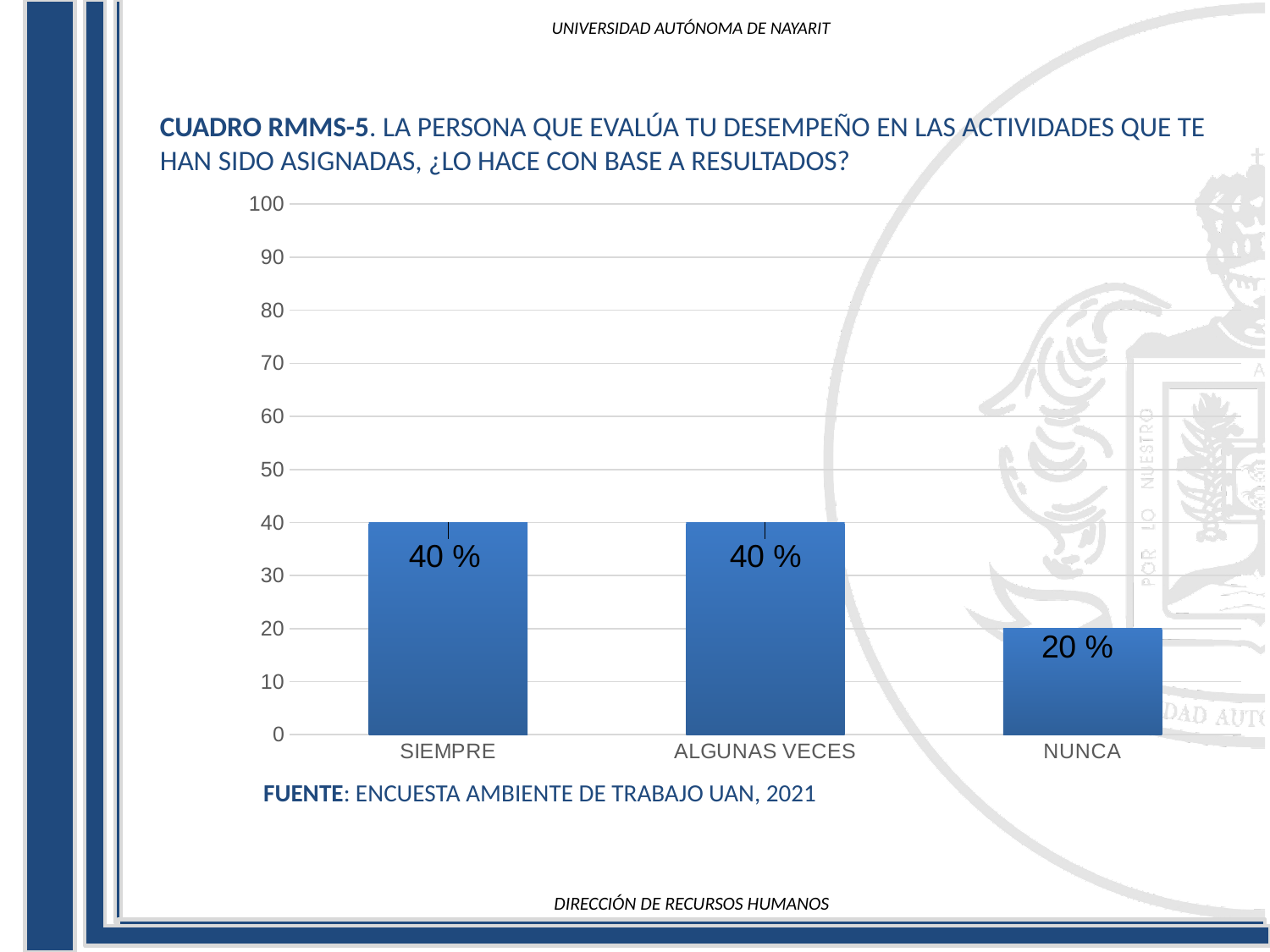
Which is larger, the value for ALGUNAS VECES or the value for NUNCA? ALGUNAS VECES What is the value for ALGUNAS VECES? 40 % Is the value for SIEMPRE greater or less than 50? less What source is cited below the chart? ENCUESTA AMBIENTE DE TRABAJO UAN, 2021 What is the value for NUNCA? 20 % How many categories are shown on the x axis? 3 Which category has the lowest value? NUNCA What is the value for SIEMPRE? 40 % What kind of chart is shown on the slide? bar chart What is the difference between the values for SIEMPRE and NUNCA? 20 % What is the highest value shown on the y axis? 100 Is the value for NUNCA greater or less than 30? less